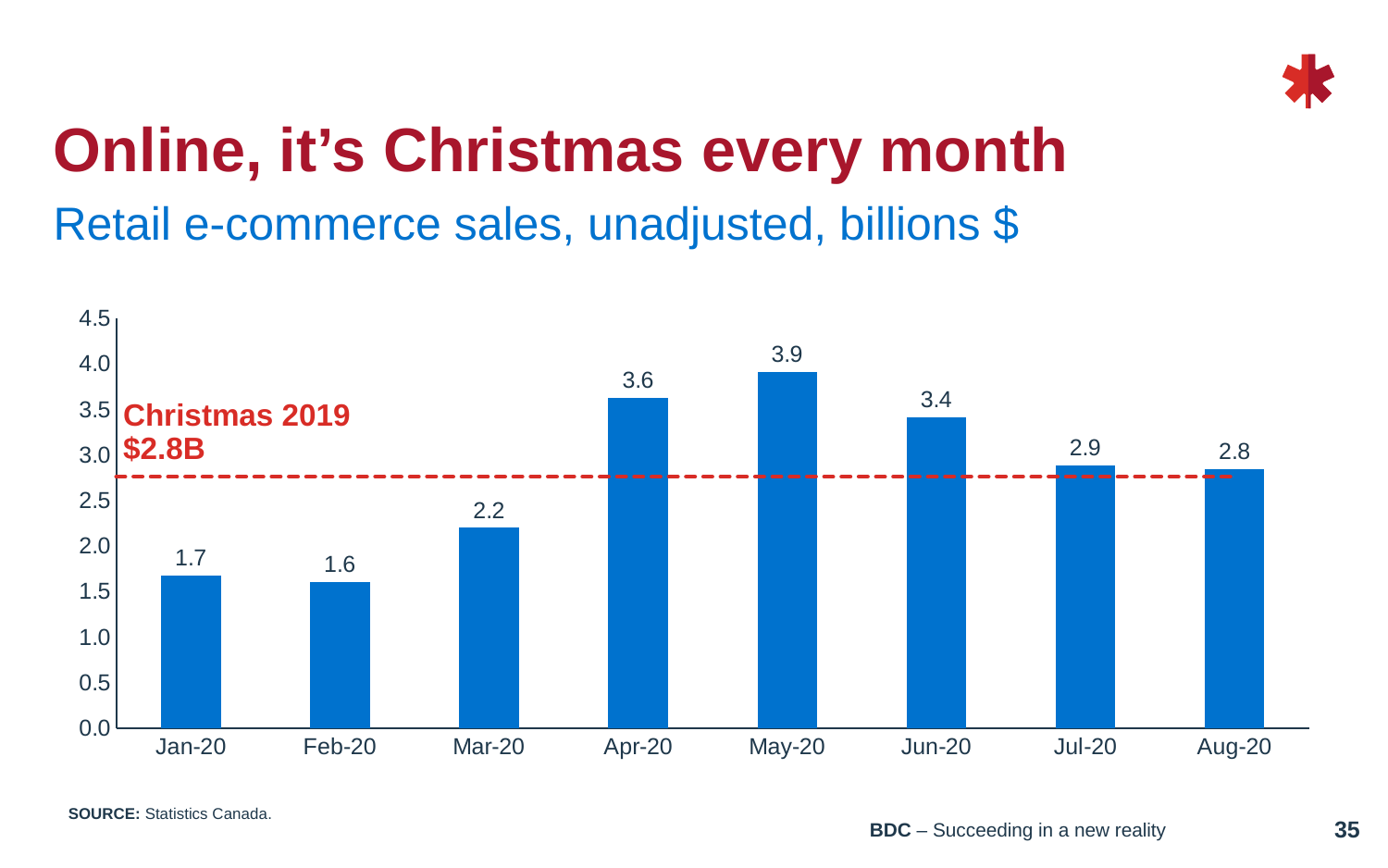
Which month has the lowest value? Feb-20 Is the value for Mar-20 greater or less than 2.5? less What kind of chart is shown on the slide? bar chart What is the value for Aug-20? 2.8 What value does the red dashed line labelled Christmas 2019 represent? $2.8B How many months are shown on the x axis? 8 What is the value for Feb-20? 1.6 Which is larger, the value for Apr-20 or the value for Jun-20? Apr-20 Do the values rise or fall from Jan-20 to May-20? rise What is the difference between the values for May-20 and Jan-20? 2.2 What is the value for May-20? 3.9 Which month has the highest value? May-20